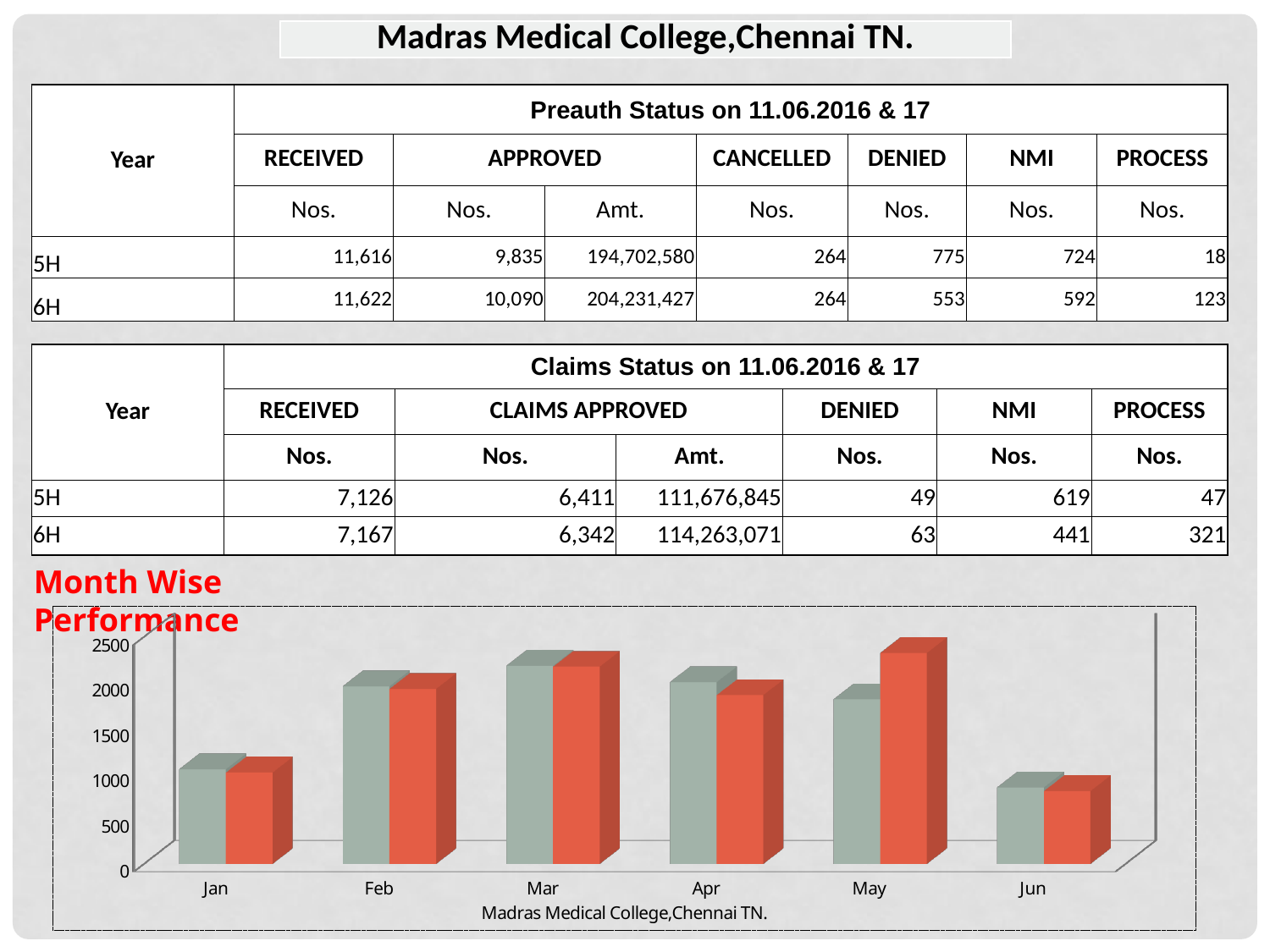
How many months are shown on the x axis of the Month Wise Performance chart? 6 What title is printed below the x axis of the Month Wise Performance chart? Madras Medical College,Chennai TN. In the Month Wise Performance chart, is the red bar for Jun greater or less than 1000? less In the Month Wise Performance chart, which month has the tallest red bar? May How many bars are plotted for each month in the Month Wise Performance chart? 2 In the Month Wise Performance chart, which month has the tallest grey bar? Mar In the Month Wise Performance chart, is the grey bar for Feb greater or less than 1500? greater In the Month Wise Performance chart, which month has the lowest bars? Jun In the Month Wise Performance chart, is the red bar for May greater or less than 2000? greater What kind of chart is shown under the heading 'Month Wise Performance'? bar chart In the Month Wise Performance chart, for May, is the red bar or the grey bar taller? red bar